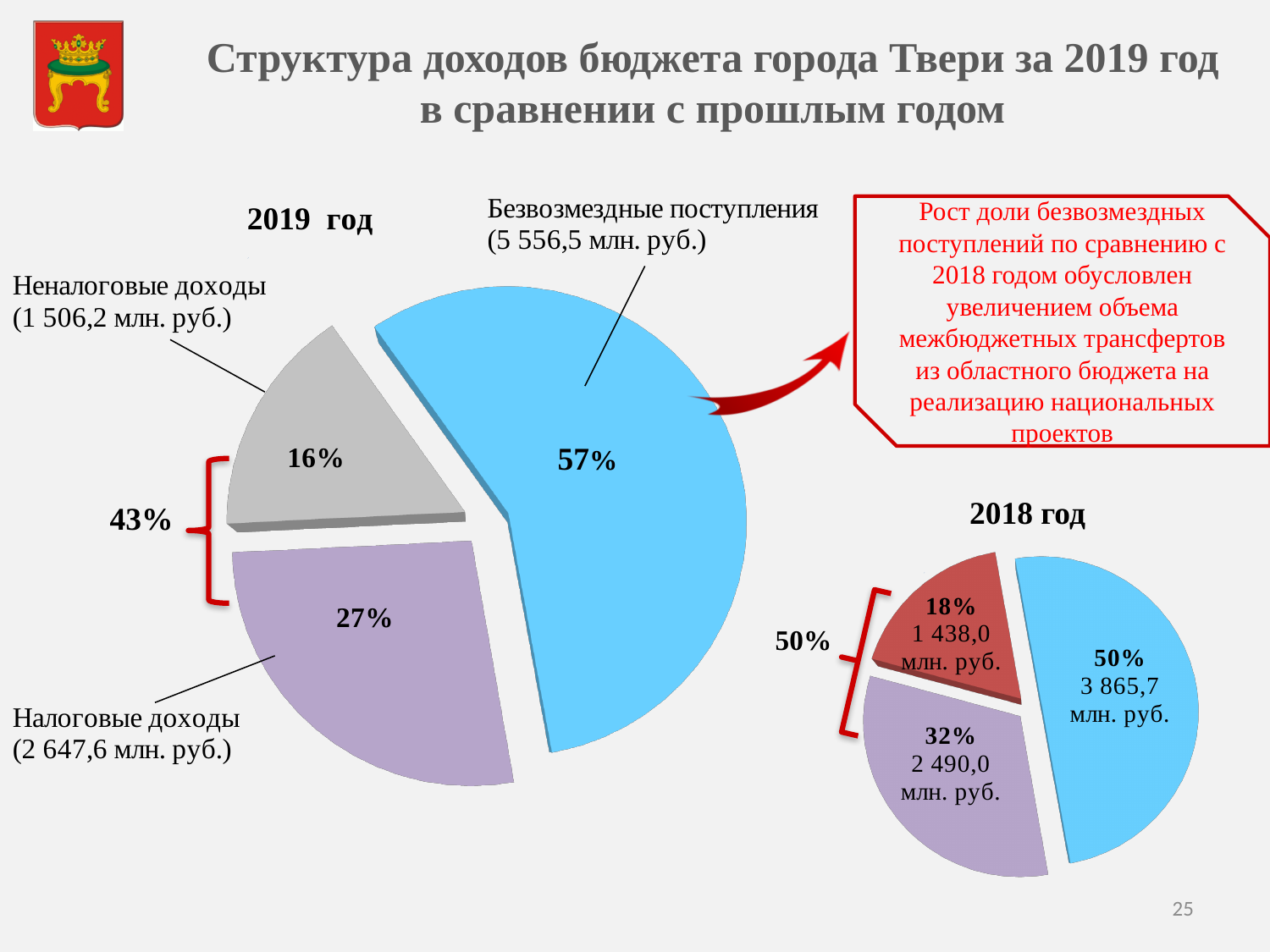
In the 2018 год chart, what is the value of the slice labelled 32%? 2 490,0 млн. руб. In the 2019 год chart, what share of the pie is Налоговые доходы? 27% What kind of charts are shown on the slide? Pie charts In the 2019 год chart, what is the difference in млн. руб. between Налоговые доходы and Неналоговые доходы? 1 141,4 млн. руб. In the 2019 год chart, what is the value for Неналоговые доходы? 1 506,2 млн. руб. In the 2018 год chart, what is the value of the slice labelled 50%? 3 865,7 млн. руб. In the 2019 год chart, which category has the smallest slice? Неналоговые доходы In the 2019 год chart, which category has the largest slice? Безвозмездные поступления In the 2018 год chart, what share of the pie is the red slice? 18% In the 2019 год chart, what share of the pie is Безвозмездные поступления? 57% In the 2019 год chart, how many slices does the pie have? 3 In the 2019 год chart, what is the value for Налоговые доходы? 2 647,6 млн. руб.